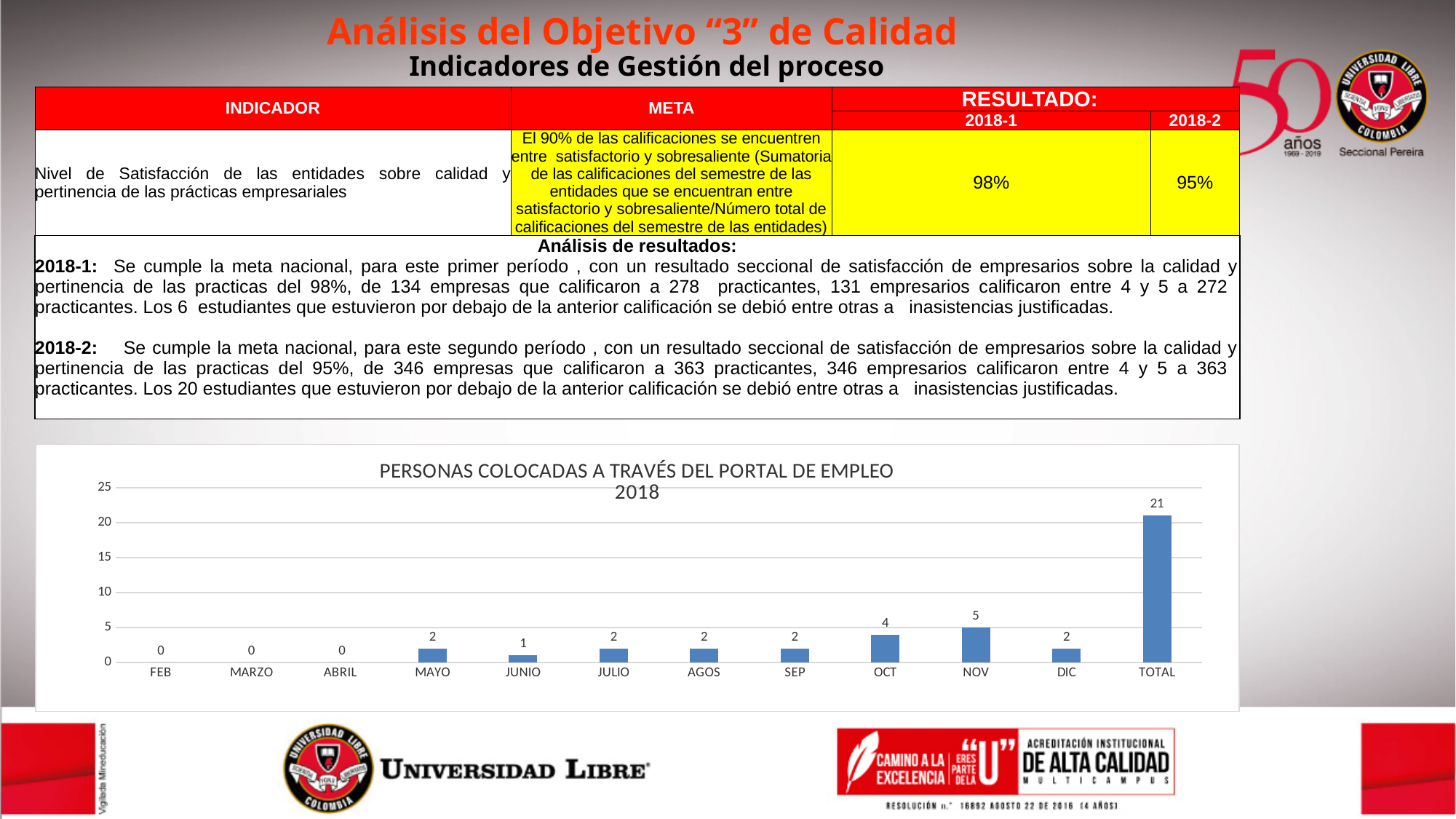
How many months show a value of 0 in the chart? 3 What is the difference between the values for NOV and OCT? 1 What kind of chart is shown on the slide? bar chart Which month (excluding TOTAL) has the highest value in the chart? NOV Which is larger, the value for OCT or the value for DIC? OCT What is the value shown for TOTAL in the chart? 21 What is the title of the chart? PERSONAS COLOCADAS A TRAVÉS DEL PORTAL DE EMPLEO 2018 What is the value for NOV in the chart? 5 What is the value for JUNIO in the chart? 1 How many categories are shown on the x axis of the chart? 12 What is the value for OCT in the chart? 4 Is the value for TOTAL greater or less than 20? greater